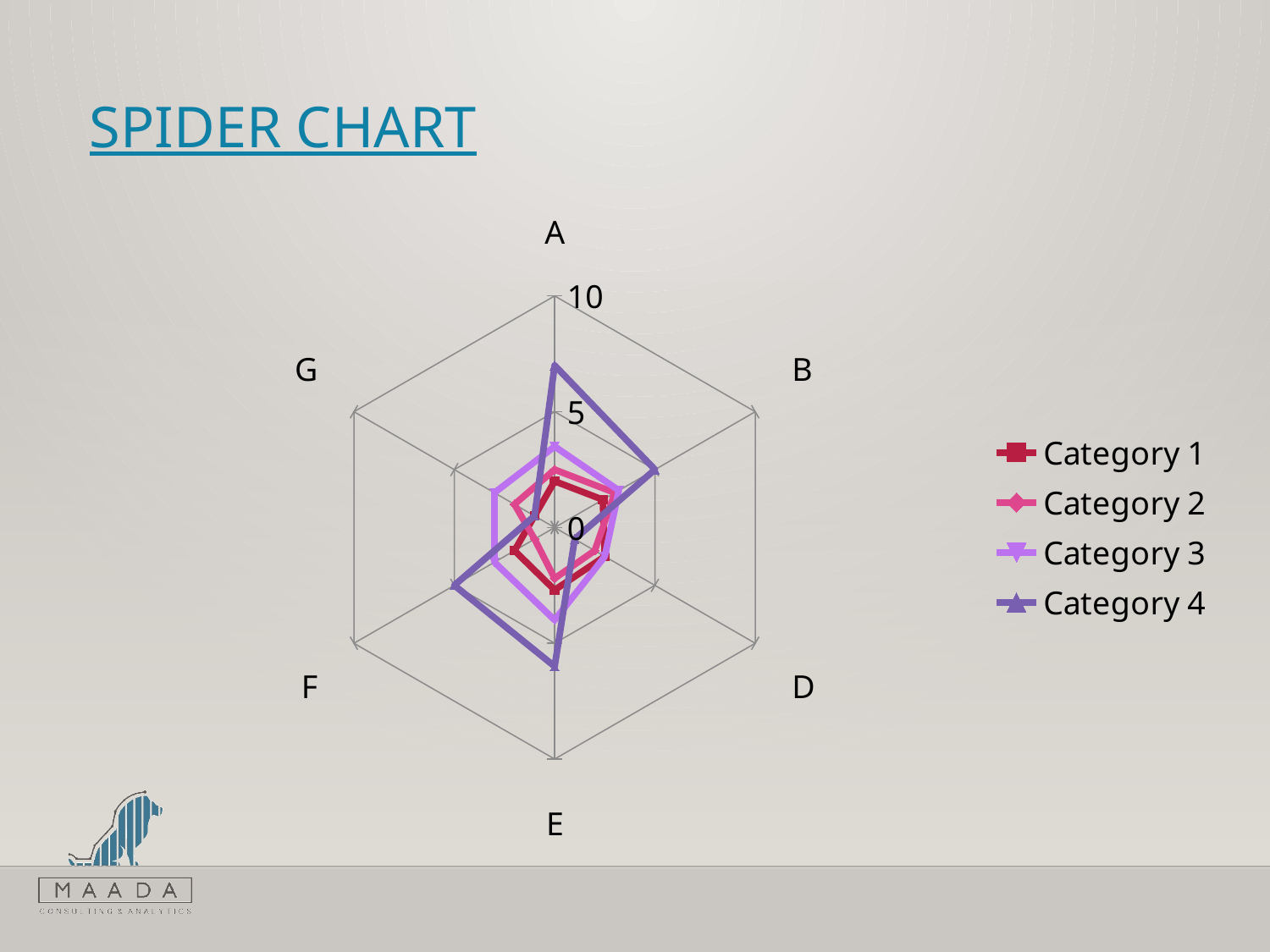
Is the value for Category 4 on axis G greater or less than 5? less What kind of chart is shown on the slide? Radar chart What is the maximum value shown on the radial axis? 10 What is the title of the slide containing the chart? SPIDER CHART How many axes (categories) does the radar chart have? 6 Is the value for Category 4 on axis A greater or less than 5? greater Is the value for Category 4 on axis D greater or less than 5? less Which series has the highest value on axis A? Category 4 How many series does the legend list? 4 On axis A, which is larger: the value for Category 4 or the value for Category 1? Category 4